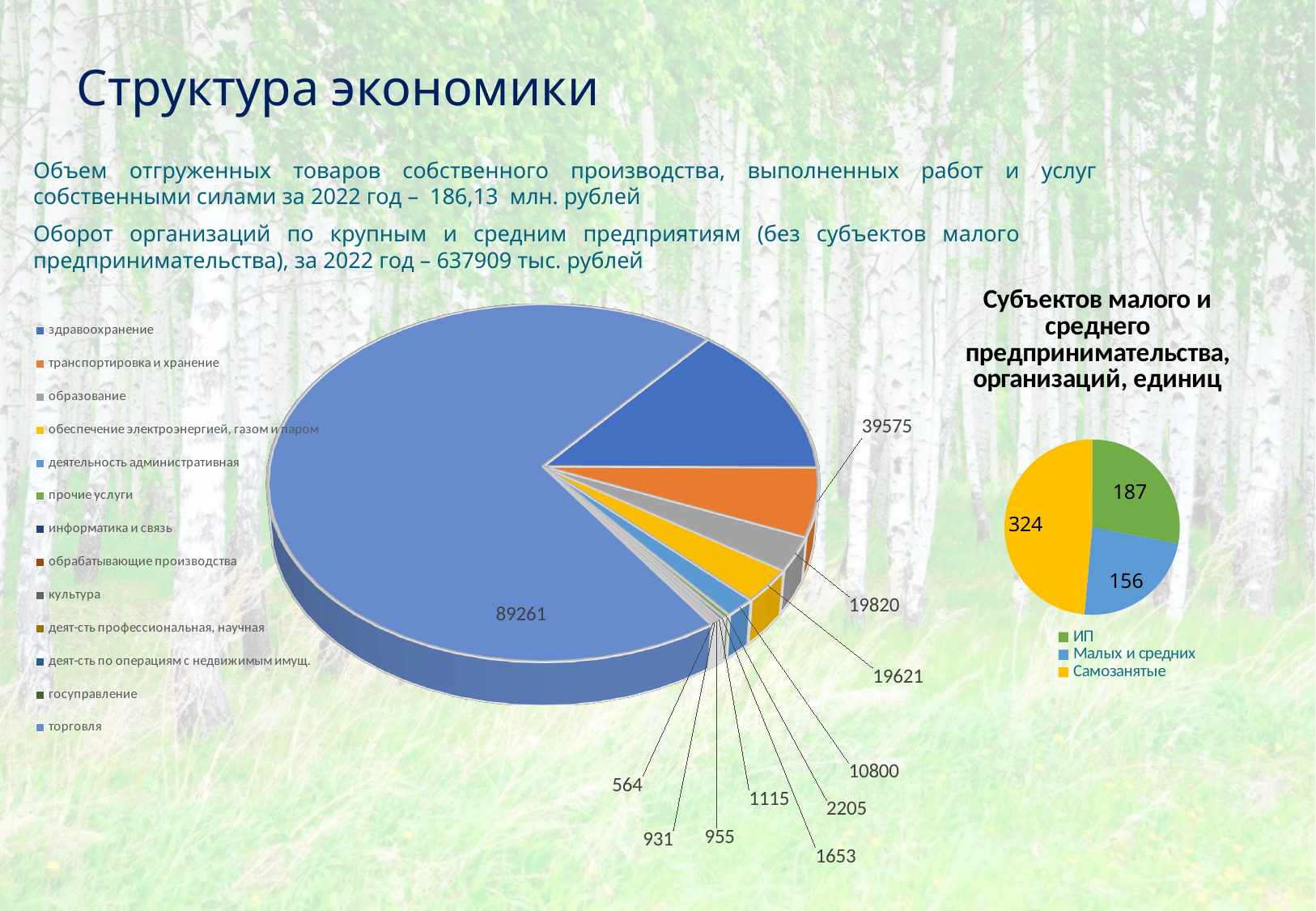
On the right pie chart (Субъектов малого и среднего предпринимательства), what is the value for ИП? 187 On the right pie chart (Субъектов малого и среднего предпринимательства), which category has the largest value? Самозанятые On the large pie chart on the left, which category has the largest slice? торговля On the right pie chart (Субъектов малого и среднего предпринимательства), what is the value for Самозанятые? 324 On the right pie chart (Субъектов малого и среднего предпринимательства), what is the total of all three categories? 667 What type of chart is the large chart on the left of the slide? Pie chart On the right pie chart (Субъектов малого и среднего предпринимательства), what is the difference between Самозанятые and Малых и средних? 168 On the right pie chart (Субъектов малого и среднего предпринимательства), which category has the smallest value? Малых и средних On the right pie chart (Субъектов малого и среднего предпринимательства), how many categories does the legend list? 3